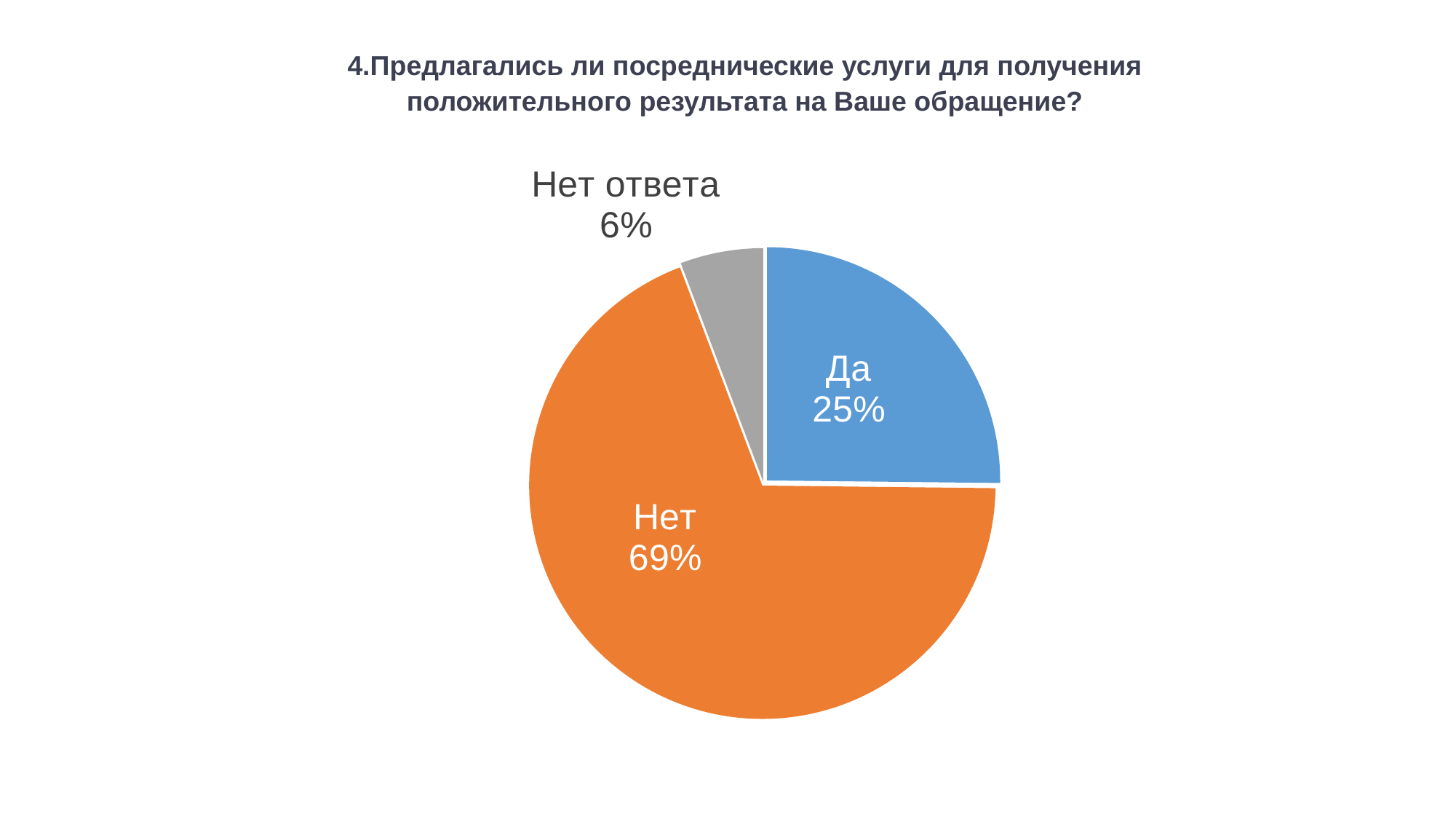
What colour is the slice for "Нет"? Orange What share of the pie does "Нет ответа" represent? 6% What colour is the slice for "Да"? Blue Which category has the smallest slice of the pie? Нет ответа What share of the pie does "Нет" represent? 69% What is the difference in percentage points between "Нет" and "Да"? 44 Which category has the largest slice of the pie? Нет Which is larger, the share for "Да" or the share for "Нет ответа"? Да How many slices does the pie chart have? 3 What share of the pie does "Да" represent? 25% What is the difference in percentage points between "Да" and "Нет ответа"? 19 What kind of chart is shown on the slide? Pie chart